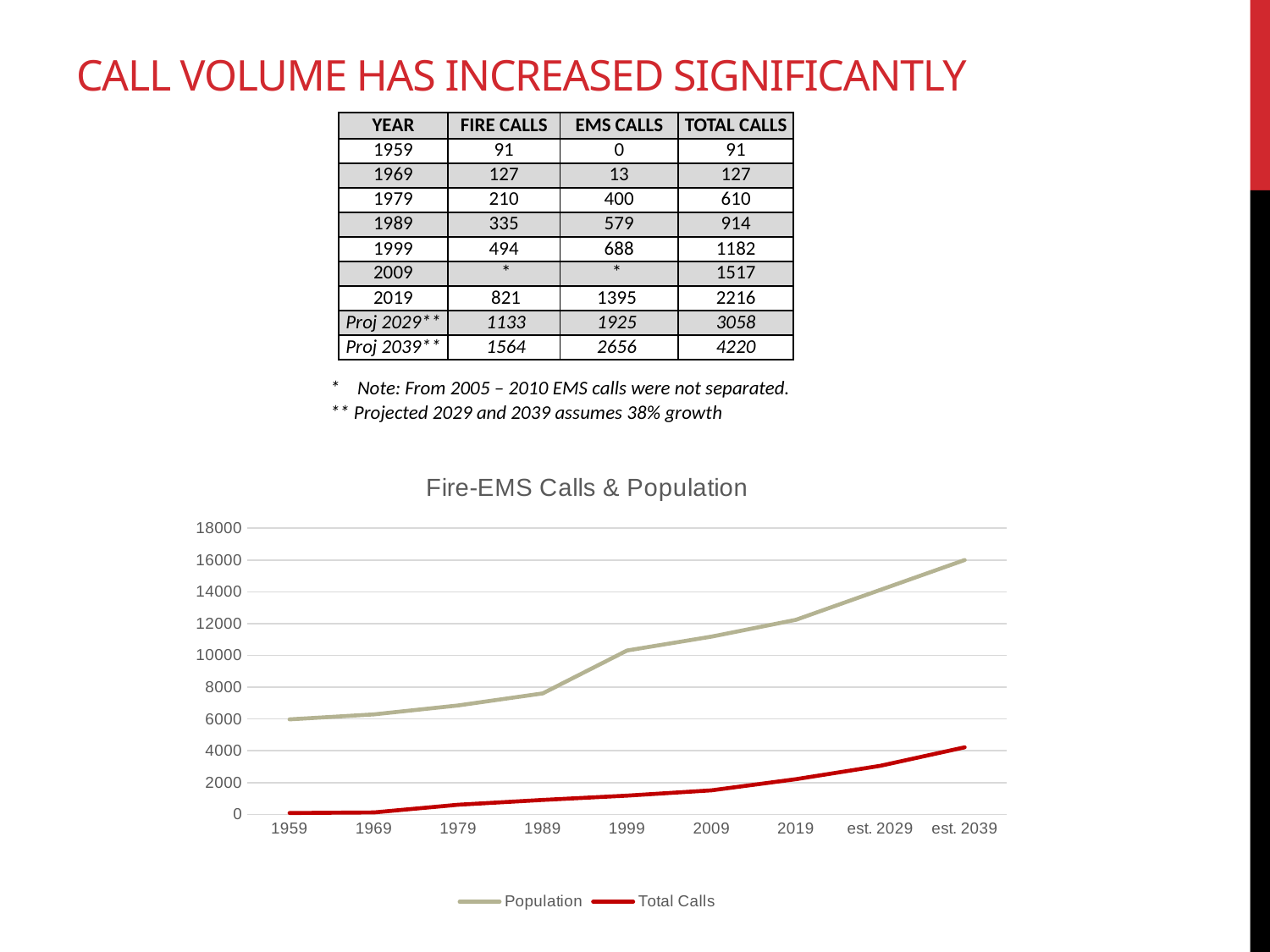
In the 'Fire-EMS Calls & Population' chart, is the Population value for 1999 greater or less than 8000? greater How many points are plotted along the x axis of the 'Fire-EMS Calls & Population' chart? 9 In the 'Fire-EMS Calls & Population' chart, does the Population series rise or fall from 1959 to est. 2039? rise In the 'Fire-EMS Calls & Population' chart, is the Total Calls value for 1999 greater or less than 2000? less In the 'Fire-EMS Calls & Population' chart, at which x-axis point is the Population series lowest? 1959 How many series does the legend of the 'Fire-EMS Calls & Population' chart list? 2 In the 'Fire-EMS Calls & Population' chart, is the Population value for 1989 greater or less than 8000? less In the 'Fire-EMS Calls & Population' chart, at which x-axis point is the Total Calls series highest? est. 2039 What colour is the Total Calls line in the 'Fire-EMS Calls & Population' chart? red In the 'Fire-EMS Calls & Population' chart, which series is higher in 2019, Population or Total Calls? Population What type of chart is the 'Fire-EMS Calls & Population' chart? line chart